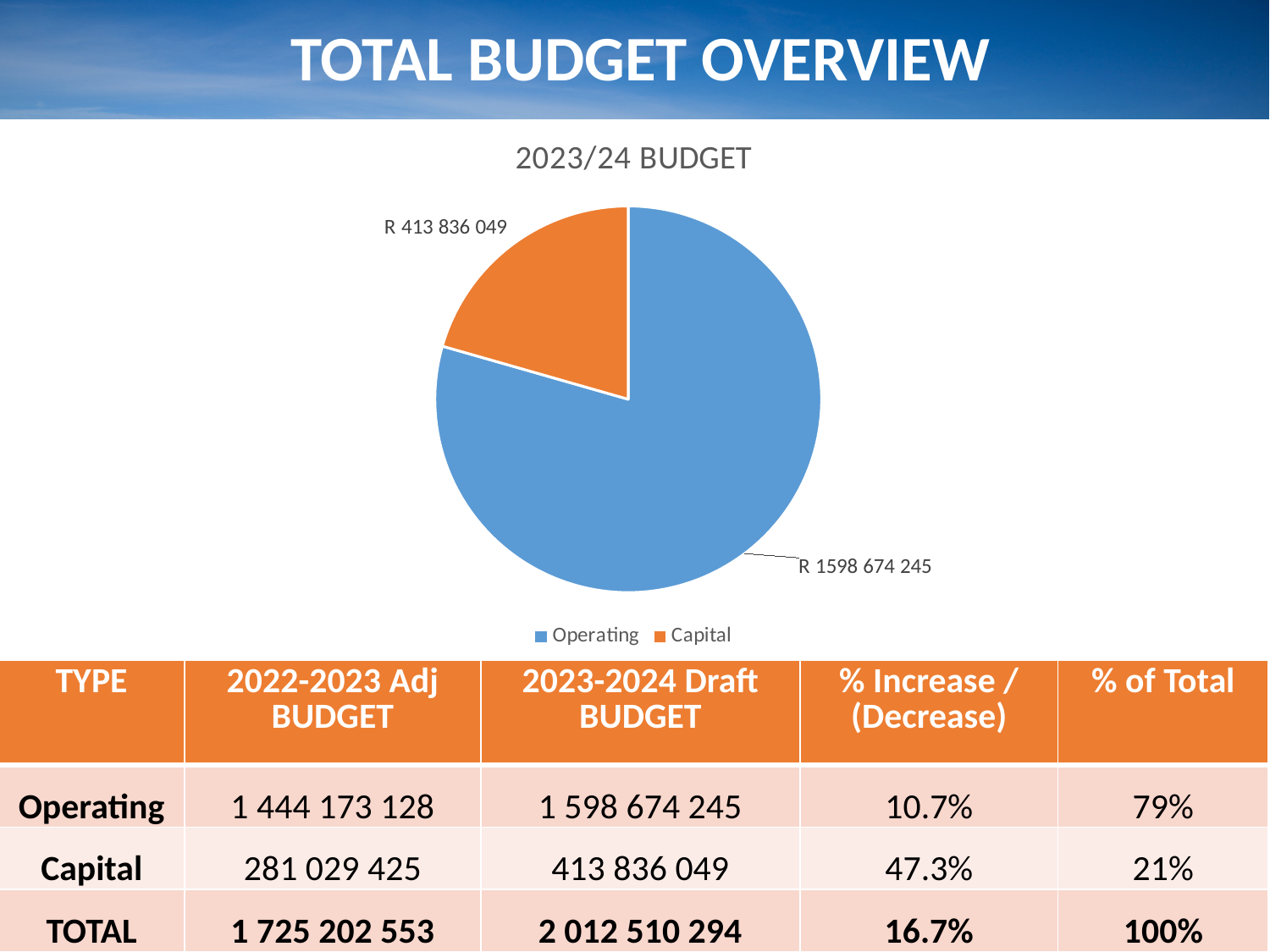
How many entries does the legend of the pie chart list? 2 Which slice of the pie chart is the largest? Operating What is the title of the chart? 2023/24 BUDGET Which is larger in the pie chart, Operating or Capital? Operating What kind of chart is shown on the slide? pie chart What is the value of the Capital slice in the pie chart? R 413 836 049 Which slice of the pie chart is the smallest? Capital What share of the total budget does the Operating slice represent? 79% What colour is the Capital slice in the pie chart? orange How many slices does the pie chart have? 2 What is the difference between the Operating and Capital values in the pie chart? R 1 184 838 196 What is the value of the Operating slice in the pie chart? R 1598 674 245